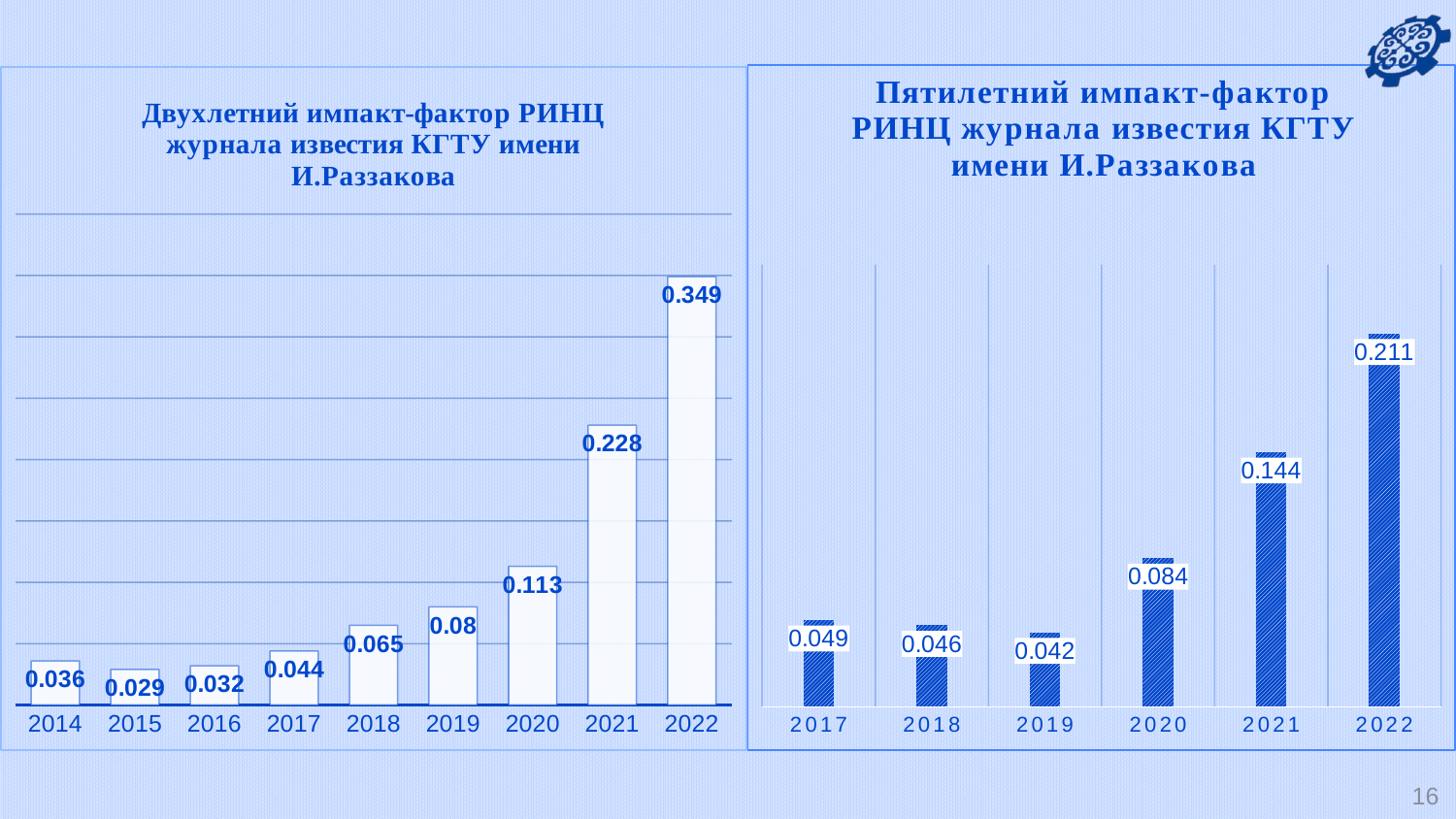
In the left chart (two-year impact factor), which is larger, the value for 2014 or the value for 2016? 2014 In the right chart (five-year impact factor), what is the value for 2020? 0.084 In the left chart (two-year impact factor), what is the value for 2022? 0.349 In the left chart (two-year impact factor), which year has the lowest value? 2015 How many years are shown on the x axis of the left chart (two-year impact factor)? 9 In the right chart (five-year impact factor), what is the difference between the 2022 and 2021 values? 0.067 In the left chart (two-year impact factor), what is the difference between the 2022 and 2021 values? 0.121 What type of chart is the right chart (five-year impact factor)? Bar chart In the right chart (five-year impact factor), which year has the highest value? 2022 In the left chart (two-year impact factor), what is the value for 2018? 0.065 In the right chart (five-year impact factor), which year has the lowest value? 2019 How many years are shown on the x axis of the right chart (five-year impact factor)? 6